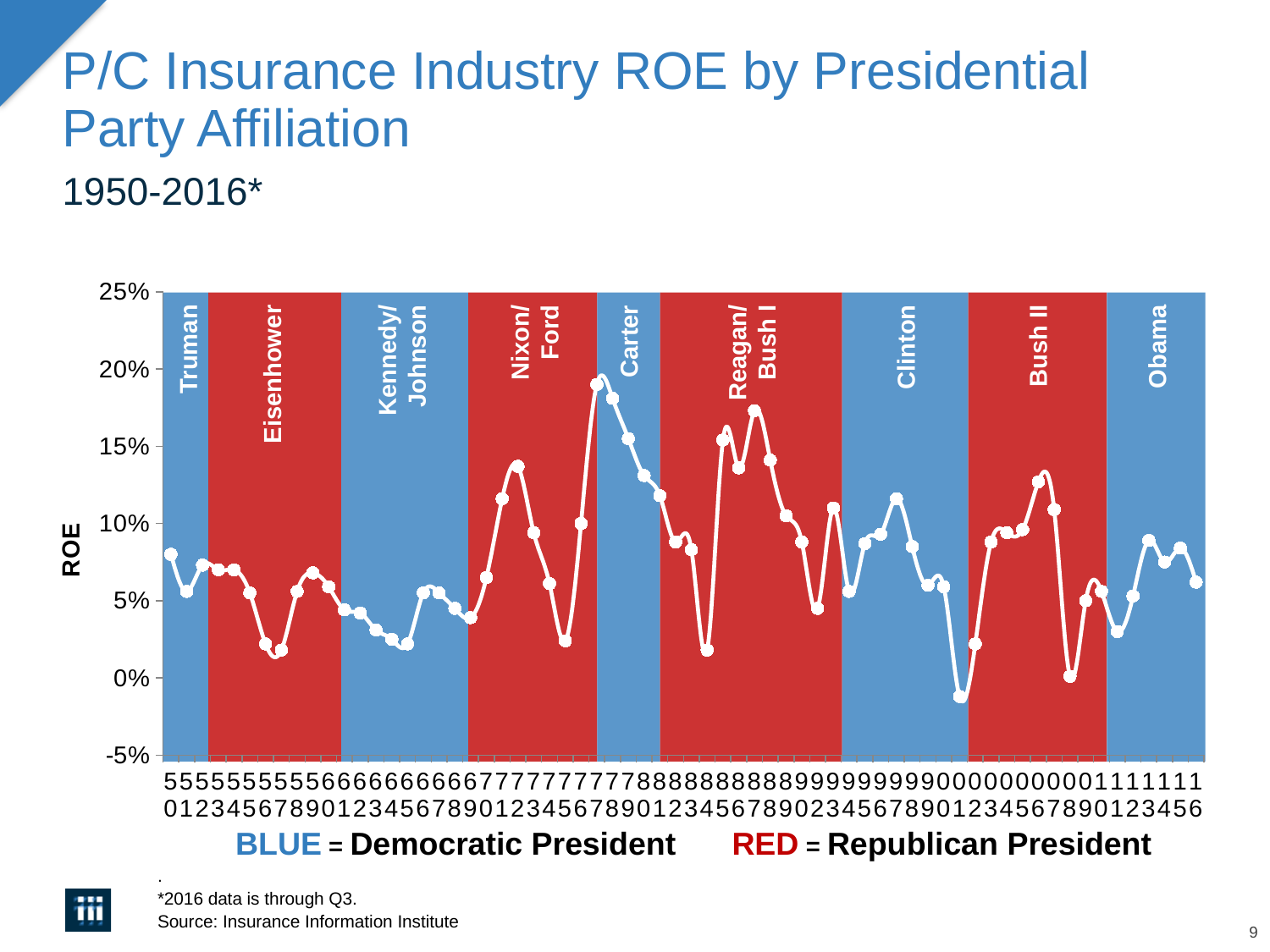
How many presidential periods are labeled across the chart? 9 In which year does the ROE line reach its lowest point? 2001 Is the ROE value for 1957 greater or less than 5%? less What is the title of the chart? P/C Insurance Industry ROE by Presidential Party Affiliation Is the ROE value for 2001 greater or less than 0%? less Which year has the larger ROE, 1977 or 2001? 1977 In which year does the ROE line reach its highest point? 1977 Is the ROE value for 1987 greater or less than 15%? greater According to the legend text below the chart, what does a blue background indicate? Democratic President What kind of chart is shown on the slide? line chart Between 1977 and 1984, does the ROE line generally rise or fall? fall